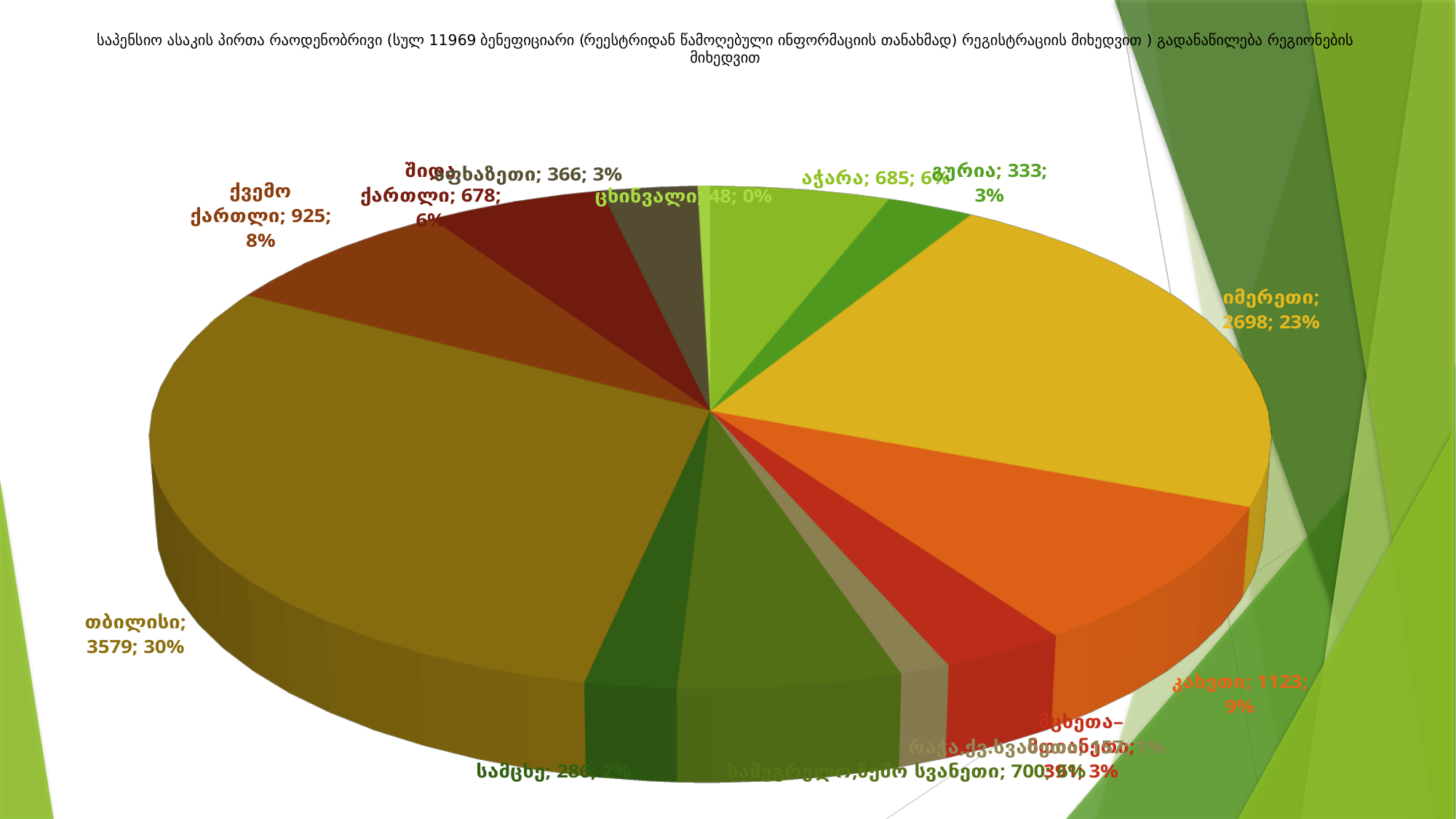
What is the value for თბილისი? 3579 Which is larger, the value for კახეთი or the value for ქვემო ქართლი? კახეთი According to the chart title, what is the total number of beneficiaries? 11969 What is the value for აჭარა? 685 What is the value for იმერეთი? 2698 Which region has the smallest slice of the pie? ცხინვალი Which region has the largest slice of the pie? თბილისი What kind of chart is shown on the slide? pie chart What is the value for გურია? 333 What share of the pie does თბილისი represent? 30% What is the difference between the values for თბილისი and იმერეთი? 881 What share of the pie does კახეთი represent? 9%